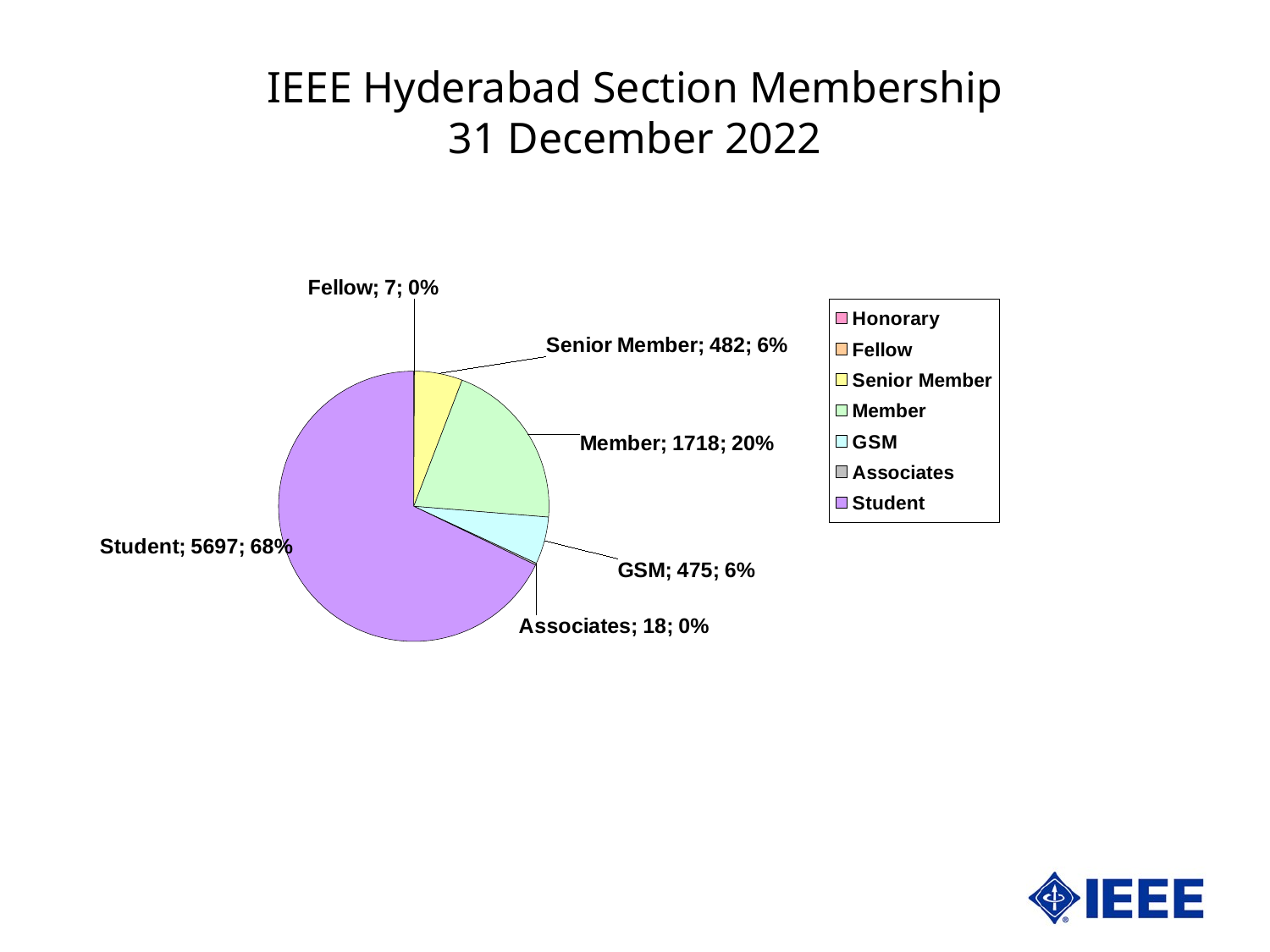
How many more members are in the Member category than in the Senior Member category? 1236 Of the slices with data labels, which category has the smallest count? Fellow What is the difference between the Senior Member count and the GSM count? 7 What is the count for the GSM slice? 475 How many Senior Members are shown on the pie chart? 482 What percentage of the membership is in the Member category? 20% What kind of chart is shown on the slide? Pie chart What share of the pie does the Student slice represent? 68% How many members are in the Student category? 5697 How many entries does the legend list? 7 Which membership category has the largest slice of the pie? Student Which has more members, Senior Member or GSM? Senior Member